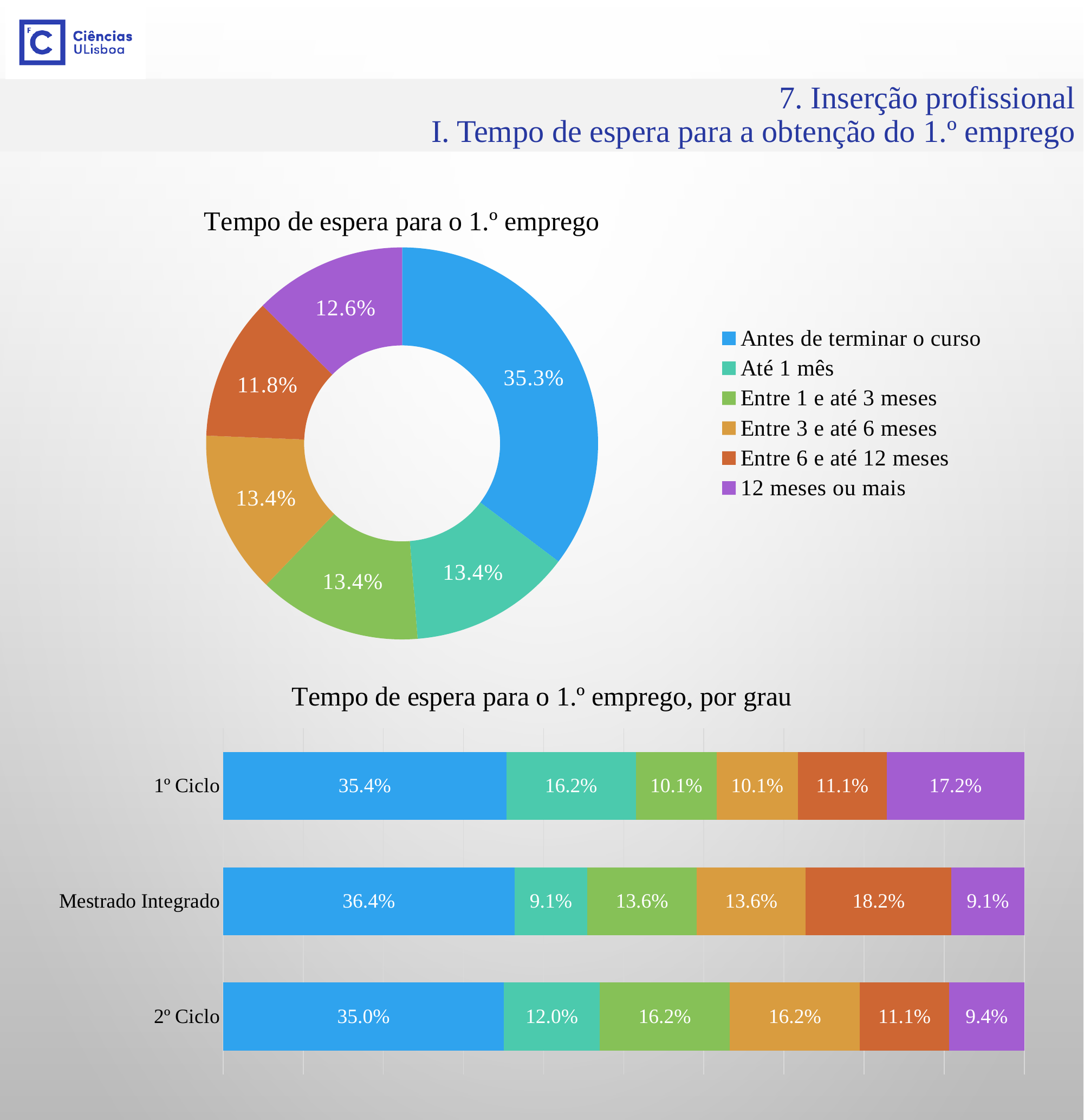
In the bar chart 'Tempo de espera para o 1.º emprego, por grau', which is larger: the red-orange segment (Entre 6 e até 12 meses) for 'Mestrado Integrado' or for '2º Ciclo'? Mestrado Integrado In the doughnut chart 'Tempo de espera para o 1.º emprego', which category has the largest share? Antes de terminar o curso What kind of chart is the lower chart 'Tempo de espera para o 1.º emprego, por grau'? Stacked bar chart In the doughnut chart 'Tempo de espera para o 1.º emprego', what is the difference between the shares for 'Antes de terminar o curso' and '12 meses ou mais'? 22.7 percentage points In the bar chart 'Tempo de espera para o 1.º emprego, por grau', what is the value of the blue segment (Antes de terminar o curso) for 'Mestrado Integrado'? 36.4% In the bar chart 'Tempo de espera para o 1.º emprego, por grau', what is the difference between the teal segment (Até 1 mês) for '1º Ciclo' and for 'Mestrado Integrado'? 7.1 percentage points In the doughnut chart 'Tempo de espera para o 1.º emprego', how many categories does the legend list? 6 In the doughnut chart 'Tempo de espera para o 1.º emprego', which category has the smallest share? Entre 6 e até 12 meses In the bar chart 'Tempo de espera para o 1.º emprego, por grau', what is the value of the purple segment (12 meses ou mais) for '1º Ciclo'? 17.2% In the bar chart 'Tempo de espera para o 1.º emprego, por grau', how many degree categories are shown on the vertical axis? 3 In the doughnut chart 'Tempo de espera para o 1.º emprego', what share is shown for 'Antes de terminar o curso'? 35.3% In the doughnut chart 'Tempo de espera para o 1.º emprego', what share is shown for 'Entre 6 e até 12 meses'? 11.8%